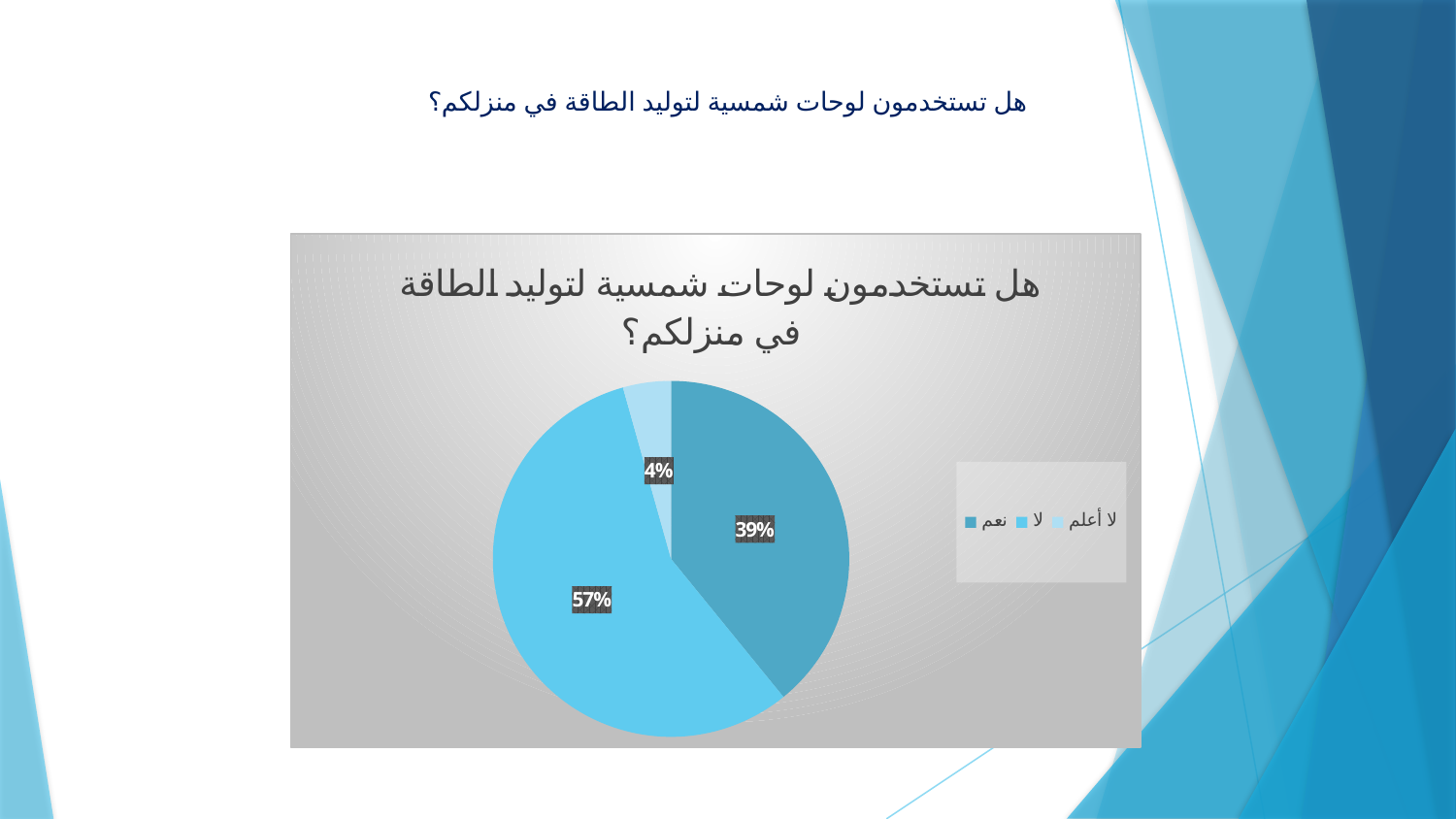
Which is larger, the "نعم" slice or the "لا" slice? لا What is the difference in percentage points between the "لا" slice and the "نعم" slice? 18 What is the combined share of the "نعم" and "لا أعلم" slices? 43% What percentage of the pie is labelled for the "نعم" slice? 39% What is the title of the chart? هل تستخدمون لوحات شمسية لتوليد الطاقة في منزلكم؟ Which category has the largest slice of the pie? لا How many slices does the pie chart have? 3 What kind of chart is shown on the slide? pie chart Which category has the smallest slice of the pie? لا أعلم What percentage of the pie is labelled for the "لا" slice? 57% What percentage of the pie is labelled for the "لا أعلم" slice? 4% How many entries does the legend list? 3